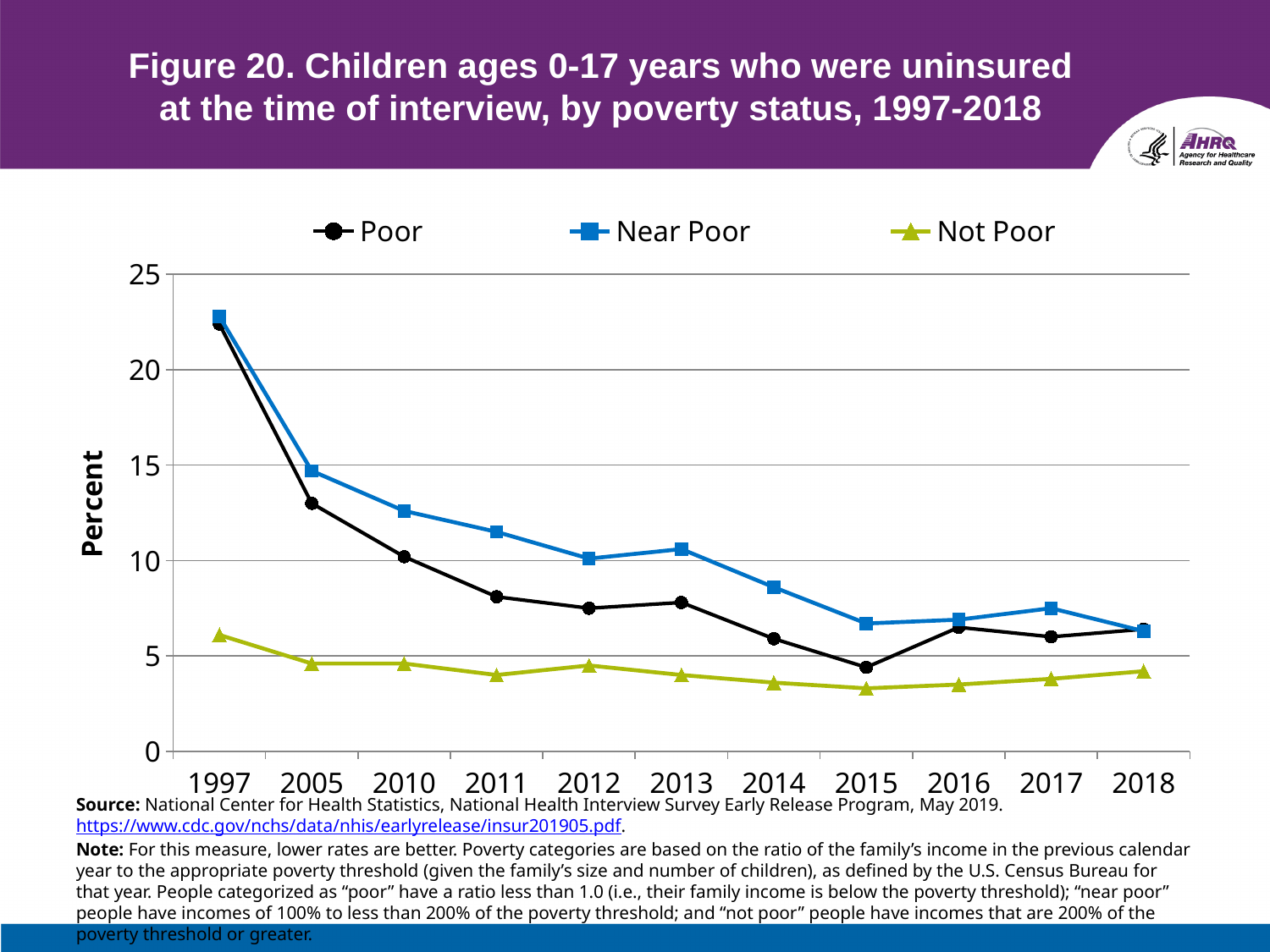
Is the value for Near Poor in 2010 greater or less than 10? greater What is the label on the vertical axis? Percent Does the value for Poor rise or fall from 1997 to 2015? fall Is the value for Near Poor in 2014 greater or less than 10? less In which year is the value for Poor highest? 1997 Is the value for Poor in 1997 greater or less than 20? greater In 2010, which is larger, the value for Poor or the value for Near Poor? Near Poor Which series does the legend show with a green triangle marker? Not Poor How many series does the legend list? 3 What kind of chart is shown on the slide? line chart How many years are plotted along the x axis? 11